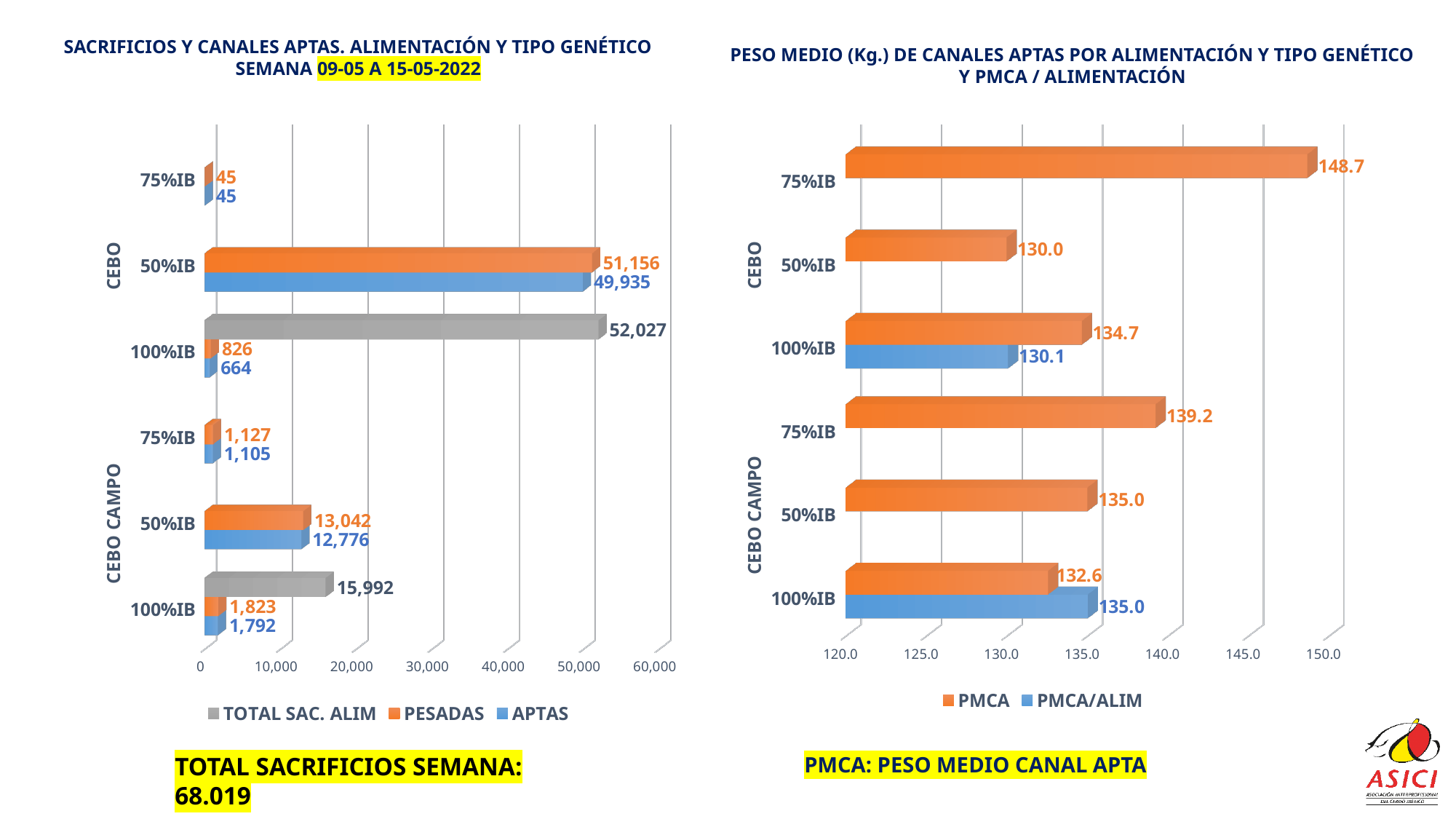
In the left chart (SACRIFICIOS Y CANALES APTAS), which category has the lowest PESADAS value? 75%IB (CEBO) In the right chart (PESO MEDIO), which is larger for 100%IB in the CEBO group: PMCA or PMCA/ALIM? PMCA In the left chart (SACRIFICIOS Y CANALES APTAS), how many series does the legend list? 3 In the right chart (PESO MEDIO), which category has the highest PMCA value? 75%IB (CEBO) In the left chart (SACRIFICIOS Y CANALES APTAS), what is the TOTAL SAC. ALIM value shown for the CEBO group? 52,027 In the left chart (SACRIFICIOS Y CANALES APTAS), what is the difference between PESADAS and APTAS for 50%IB in the CEBO group? 1,221 In the left chart (SACRIFICIOS Y CANALES APTAS), what is the APTAS value for 50%IB in the CEBO CAMPO group? 12,776 What type of chart is the right chart (PESO MEDIO)? Bar chart In the right chart (PESO MEDIO), what is the PMCA/ALIM value for 100%IB in the CEBO CAMPO group? 135.0 In the right chart (PESO MEDIO), what is the difference between the PMCA values for 75%IB in CEBO and 75%IB in CEBO CAMPO? 9.5 In the right chart (PESO MEDIO), what is the PMCA value for 75%IB in the CEBO group? 148.7 In the left chart (SACRIFICIOS Y CANALES APTAS), what is the PESADAS value for 50%IB in the CEBO group? 51,156